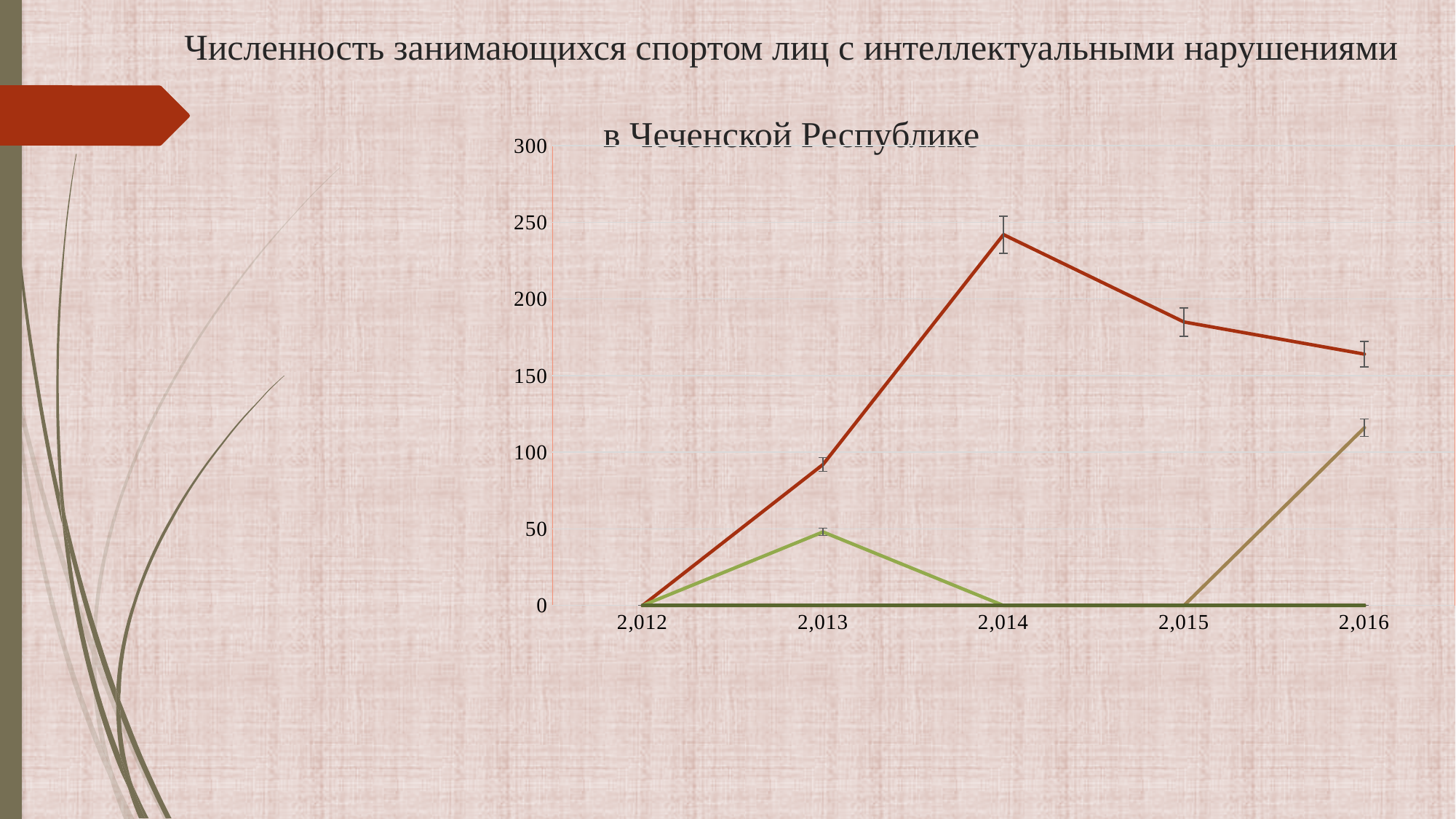
Is the value of the light green line in 2,013 greater or less than 100? less How many years are shown along the x axis of the chart? 5 Is the value of the red line in 2,014 greater or less than 200? greater Is the value of the red line in 2,015 greater or less than 200? less In which year does the red line reach its highest value? 2,014 Does the red line rise or fall from 2,014 to 2,016? fall Which is larger: the red line's value in 2,014 or its value in 2,016? 2,014 What kind of chart is shown on the slide? line chart What is the title of the chart on the slide? Численность занимающихся спортом лиц с интеллектуальными нарушениями в Чеченской Республике